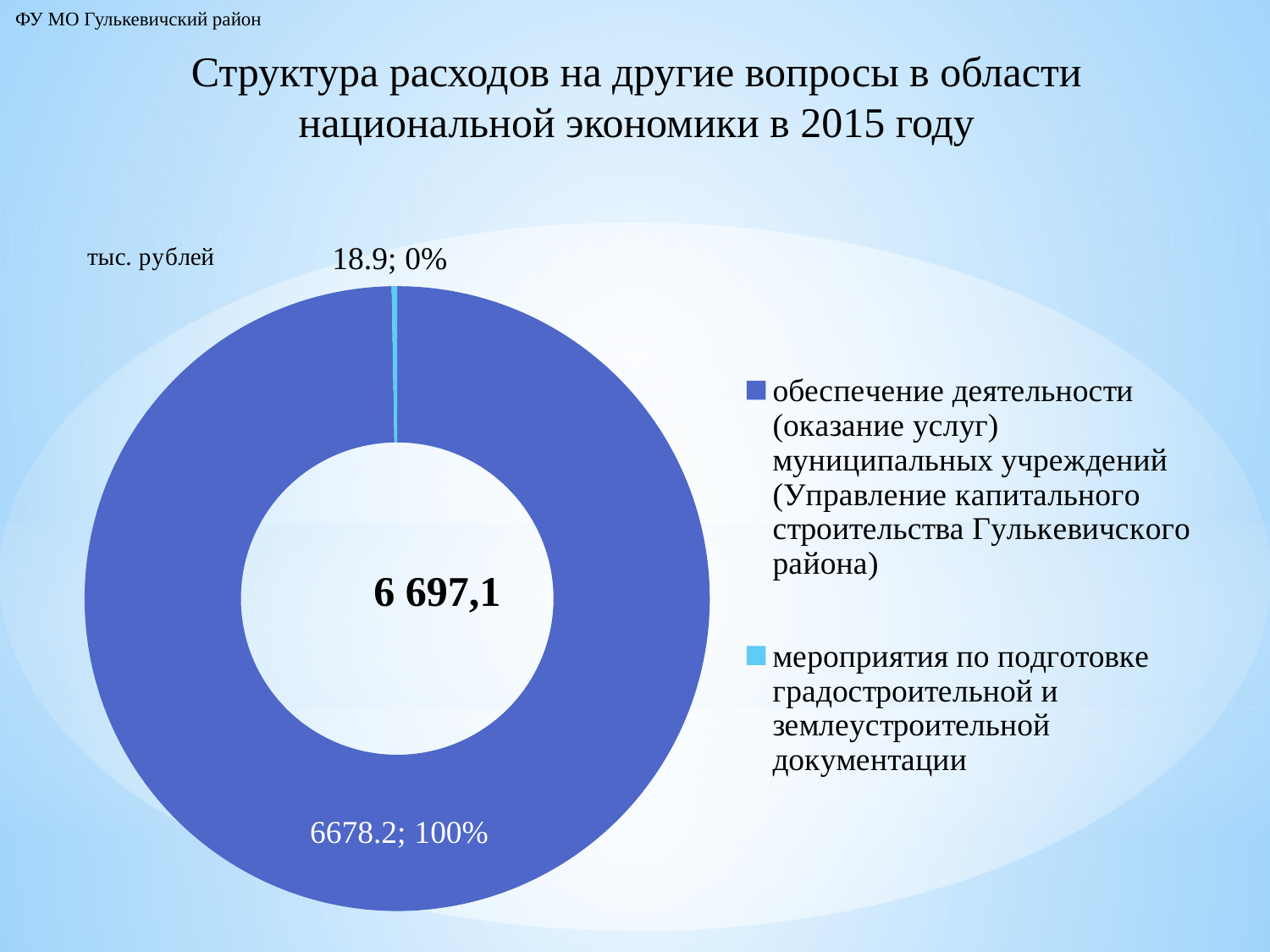
What total value is shown in the centre of the chart? 6 697,1 How many entries does the legend list? 2 Which category has the smallest value? мероприятия по подготовке градостроительной и землеустроительной документации Which category has the largest value? обеспечение деятельности (оказание услуг) муниципальных учреждений (Управление капитального строительства Гулькевичского района) How many categories (slices) does the chart have? 2 What share of the chart does "обеспечение деятельности (оказание услуг) муниципальных учреждений" account for? 100% In what units are the chart values given? тыс. рублей What type of chart is shown on the slide? Doughnut (pie) chart What is the value for "обеспечение деятельности (оказание услуг) муниципальных учреждений (Управление капитального строительства Гулькевичского района)"? 6678.2 What is the difference between the value for "обеспечение деятельности" (6678.2) and the value for "мероприятия по подготовке градостроительной и землеустроительной документации" (18.9)? 6659.3 What is the value for "мероприятия по подготовке градостроительной и землеустроительной документации"? 18.9 What share of the chart does "мероприятия по подготовке градостроительной и землеустроительной документации" account for? 0%